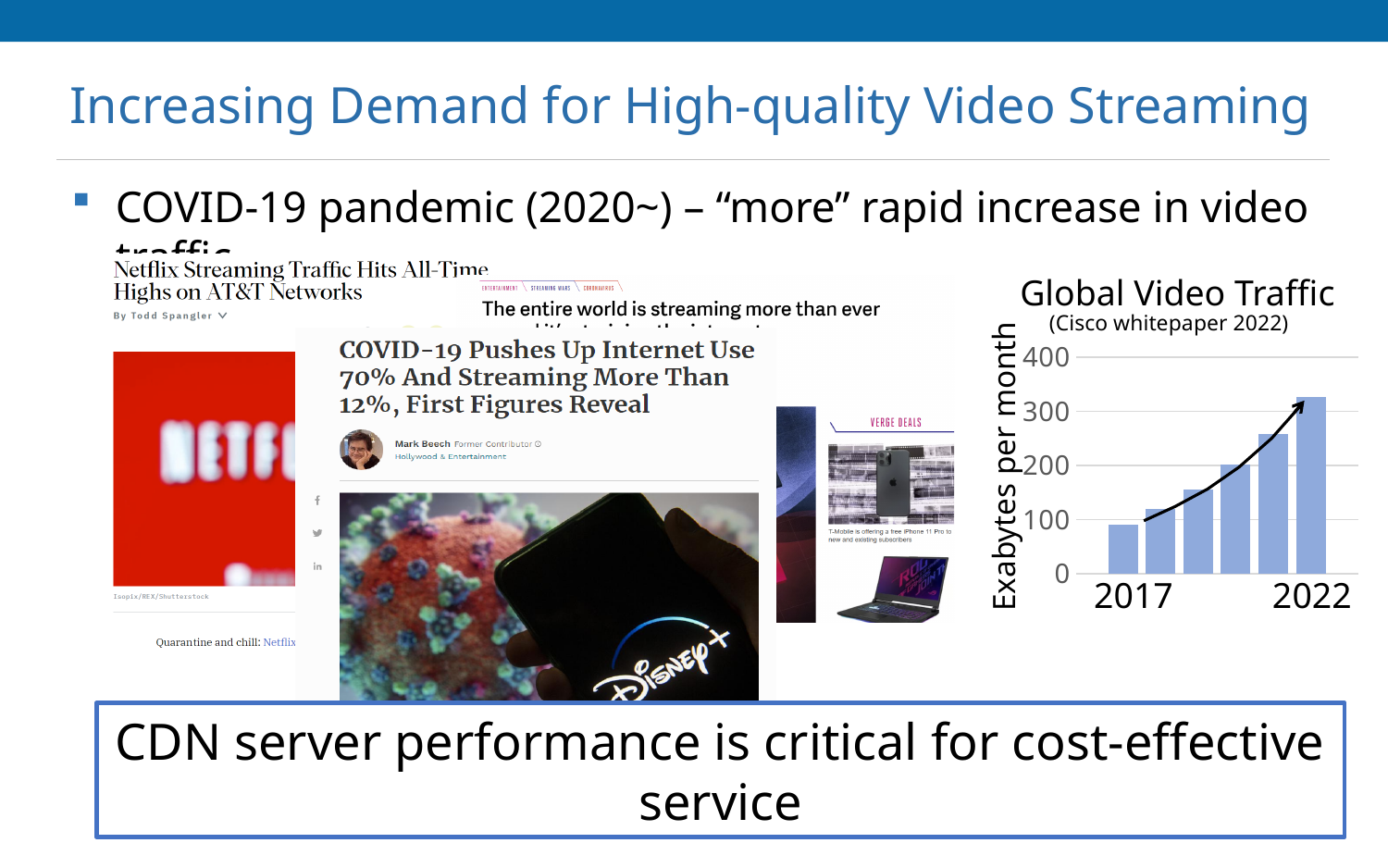
What is the y-axis label of the Global Video Traffic chart? Exabytes per month In the Global Video Traffic chart, which year has the larger value, 2017 or 2022? 2022 What source is cited under the title of the Global Video Traffic chart? Cisco whitepaper 2022 How many bars are plotted in the Global Video Traffic chart? 6 In the Global Video Traffic chart, is the value for 2022 greater or less than 400? less In the Global Video Traffic chart, is the value for 2022 greater or less than 300? greater Which year has the highest value in the Global Video Traffic chart? 2022 Which year has the lowest value in the Global Video Traffic chart? 2017 In the Global Video Traffic chart, is the value for 2017 greater or less than 100? less What kind of chart is the Global Video Traffic chart? bar chart In the Global Video Traffic chart, do the values rise or fall from 2017 to 2022? rise